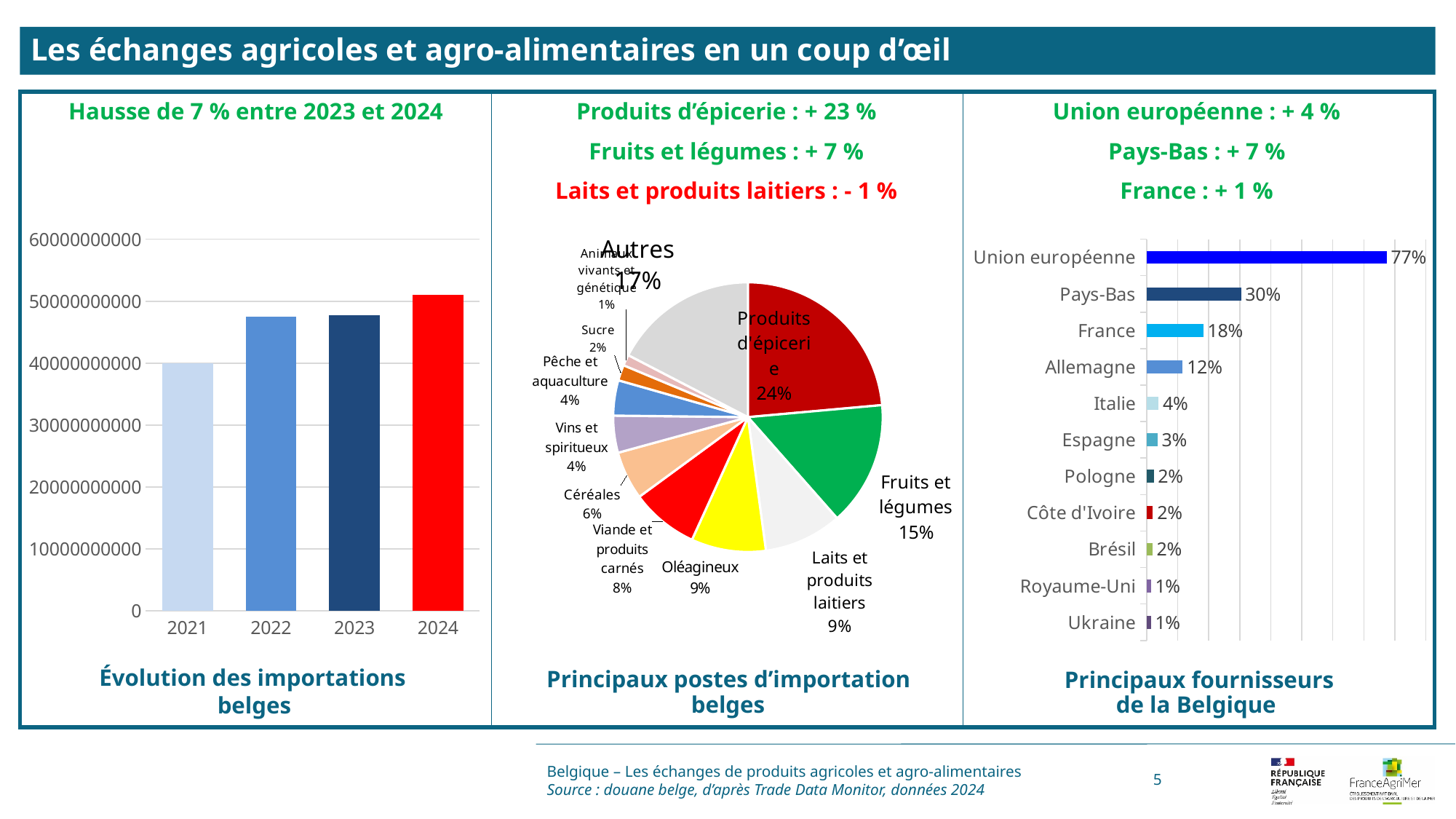
In the chart 'Évolution des importations belges', is the value for 2021 greater or less than 50000000000? less In the chart 'Principaux fournisseurs de la Belgique', what is the value for Allemagne? 12% How many categories are shown in the chart 'Principaux fournisseurs de la Belgique'? 11 In the chart 'Principaux fournisseurs de la Belgique', what is the difference between the values for Pays-Bas and France? 12% In the pie chart 'Principaux postes d'importation belges', what share does 'Produits d'épicerie' have? 24% In the chart 'Évolution des importations belges', which year has the lowest bar? 2021 In the chart 'Évolution des importations belges', do the values generally rise or fall from 2021 to 2024? rise In the pie chart 'Principaux postes d'importation belges', what is the difference between the shares of 'Fruits et légumes' and 'Céréales'? 9% In the chart 'Évolution des importations belges', which year has the highest bar? 2024 What kind of chart is 'Principaux postes d'importation belges'? pie chart In the pie chart 'Principaux postes d'importation belges', which is larger: 'Viande et produits carnés' or 'Vins et spiritueux'? Viande et produits carnés In the chart 'Évolution des importations belges', is the value for 2024 greater or less than 50000000000? greater